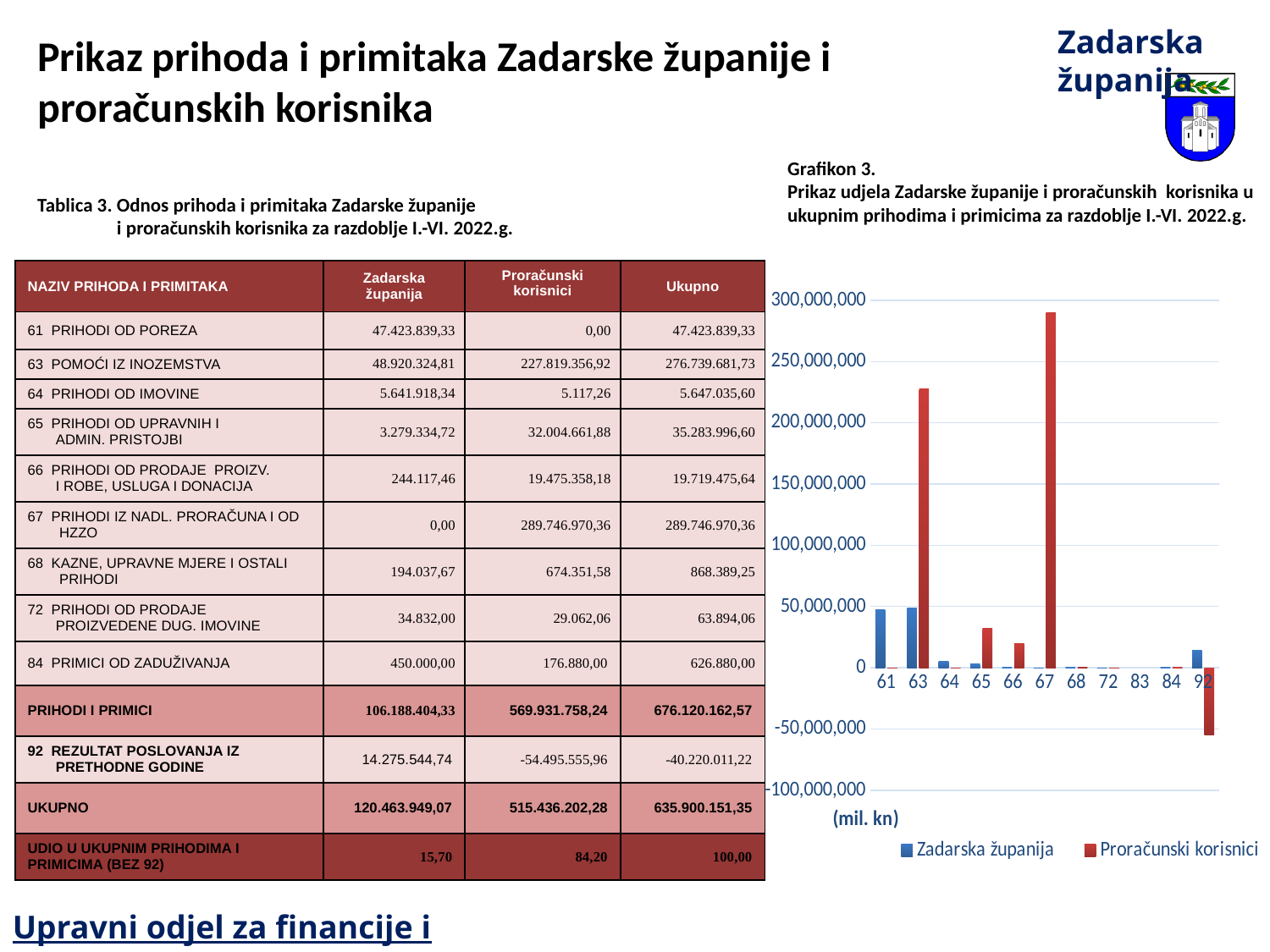
In Grafikon 3, is the Proračunski korisnici value for category 63 greater or less than 200,000,000? greater In Grafikon 3, which series is shown in red? Proračunski korisnici In Grafikon 3, which category has the highest value for Proračunski korisnici? 67 In Grafikon 3, is the Proračunski korisnici value for category 92 greater or less than 0? less How many categories are shown on the x axis of Grafikon 3? 11 What kind of chart is Grafikon 3? bar chart In Grafikon 3, which is larger for category 61: Zadarska županija or Proračunski korisnici? Zadarska županija How many series does the legend of Grafikon 3 list? 2 In Grafikon 3, is the Proračunski korisnici value for category 67 greater or less than 250,000,000? greater In Grafikon 3, which category has the lowest value for Proračunski korisnici? 92 In Grafikon 3, which is larger for category 65: Zadarska županija or Proračunski korisnici? Proračunski korisnici